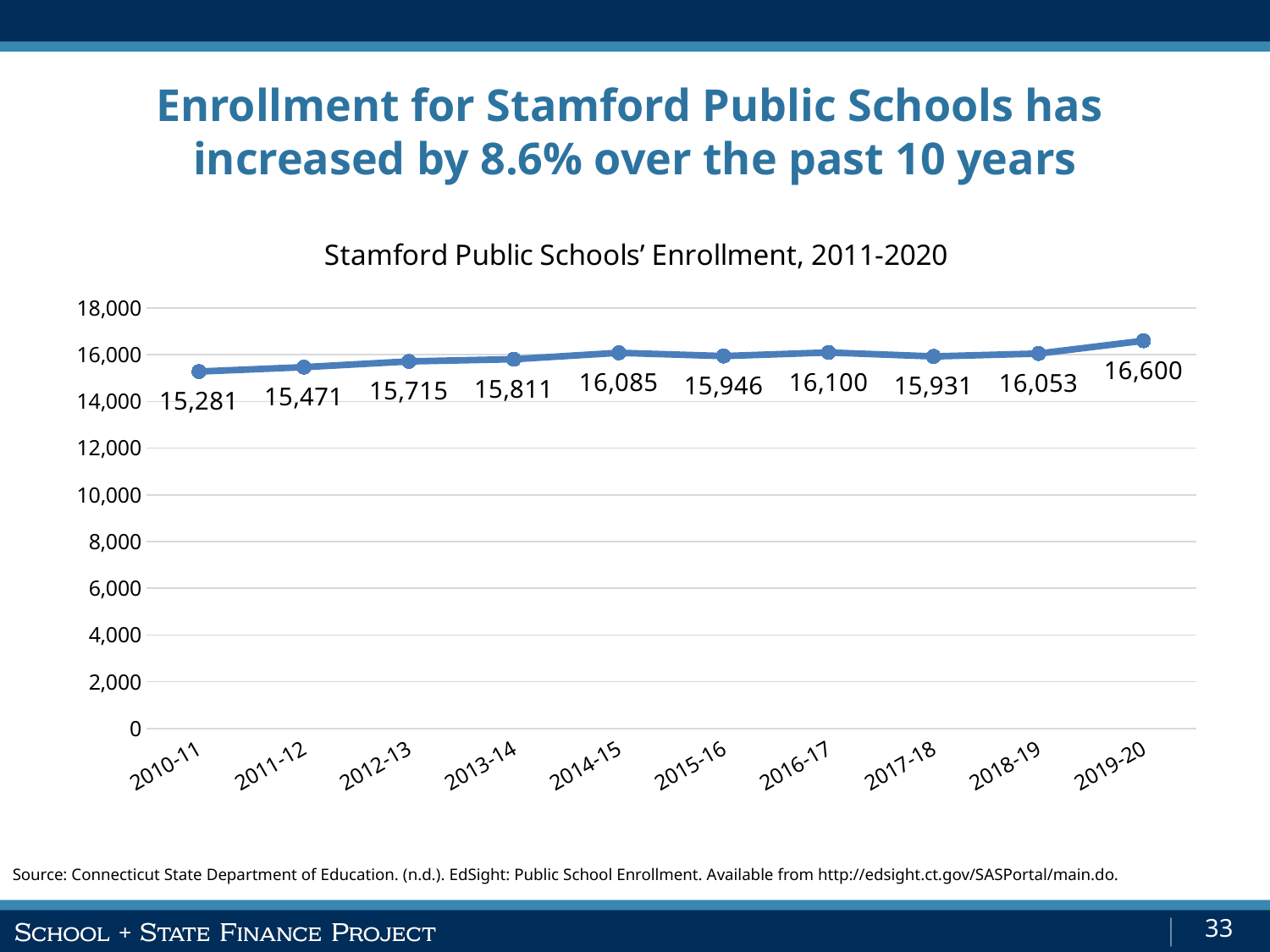
What was Stamford Public Schools' enrollment in 2010-11? 15,281 Which school year had the highest enrollment? 2019-20 What was Stamford Public Schools' enrollment in 2019-20? 16,600 Which year had higher enrollment, 2015-16 or 2016-17? 2016-17 What is the title of the chart? Stamford Public Schools' Enrollment, 2011-2020 What type of chart is shown on the slide? Line chart What was the enrollment in 2014-15? 16,085 What is the difference in enrollment between 2016-17 and 2017-18? 169 How many school years are plotted on the chart? 10 Which school year had the lowest enrollment? 2010-11 By how much did enrollment increase from 2010-11 to 2019-20? 1,319 Is the enrollment for 2019-20 greater or less than 16,000? greater